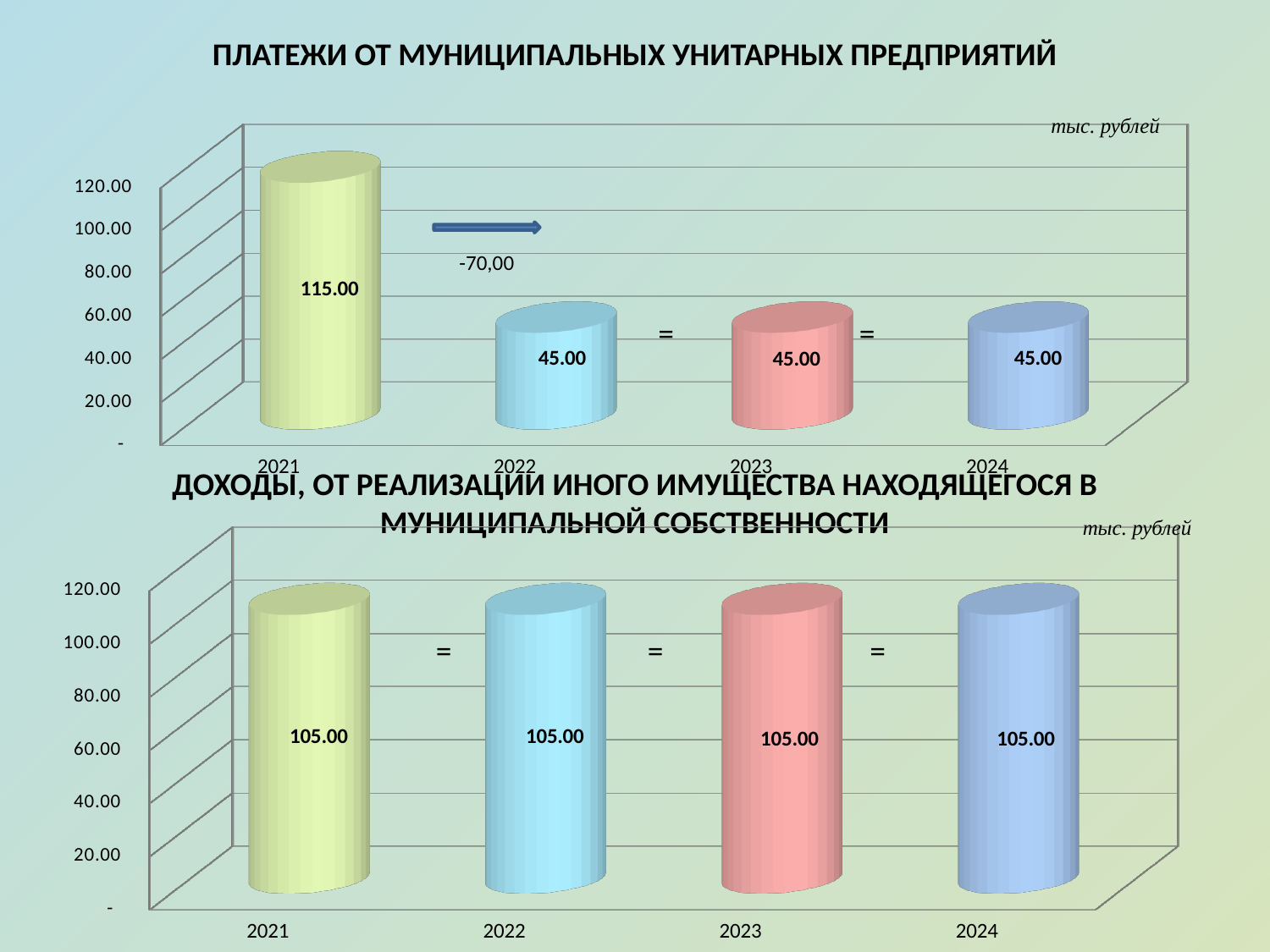
In the top chart (ПЛАТЕЖИ ОТ МУНИЦИПАЛЬНЫХ УНИТАРНЫХ ПРЕДПРИЯТИЙ), which year has the highest value? 2021 In the top chart (ПЛАТЕЖИ ОТ МУНИЦИПАЛЬНЫХ УНИТАРНЫХ ПРЕДПРИЯТИЙ), what is the value for 2023? 45.00 In the bottom chart (ДОХОДЫ, ОТ РЕАЛИЗАЦИИ ИНОГО ИМУЩЕСТВА), what is the value for 2024? 105.00 In the bottom chart (ДОХОДЫ, ОТ РЕАЛИЗАЦИИ ИНОГО ИМУЩЕСТВА), is the value for 2023 greater or less than 100.00? greater In the bottom chart (ДОХОДЫ, ОТ РЕАЛИЗАЦИИ ИНОГО ИМУЩЕСТВА), what is the value for 2022? 105.00 In the top chart (ПЛАТЕЖИ ОТ МУНИЦИПАЛЬНЫХ УНИТАРНЫХ ПРЕДПРИЯТИЙ), do the values rise or fall from 2021 to 2022? fall What unit is indicated in the top right corner of the top chart? тыс. рублей What kind of chart is the bottom chart (ДОХОДЫ, ОТ РЕАЛИЗАЦИИ ИНОГО ИМУЩЕСТВА)? bar chart In the top chart (ПЛАТЕЖИ ОТ МУНИЦИПАЛЬНЫХ УНИТАРНЫХ ПРЕДПРИЯТИЙ), what is the difference between the 2021 value and the 2022 value? 70.00 In the top chart (ПЛАТЕЖИ ОТ МУНИЦИПАЛЬНЫХ УНИТАРНЫХ ПРЕДПРИЯТИЙ), what is the value for 2021? 115.00 In the top chart (ПЛАТЕЖИ ОТ МУНИЦИПАЛЬНЫХ УНИТАРНЫХ ПРЕДПРИЯТИЙ), which is larger, the value for 2021 or the value for 2024? 2021 In the top chart (ПЛАТЕЖИ ОТ МУНИЦИПАЛЬНЫХ УНИТАРНЫХ ПРЕДПРИЯТИЙ), how many years are shown on the x axis? 4